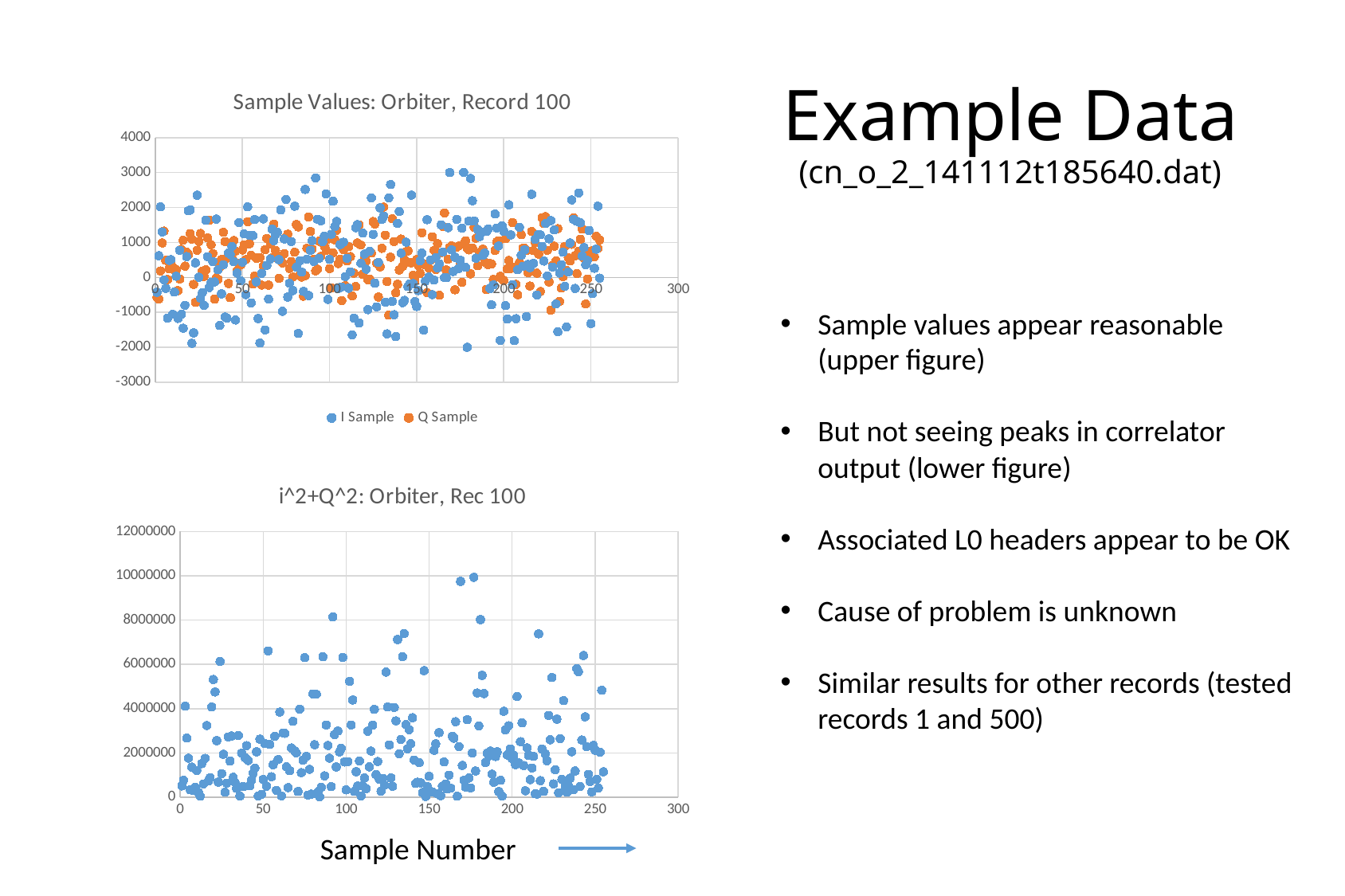
What kind of chart is the lower chart titled "i^2+Q^2: Orbiter, Rec 100"? scatter chart In the lower chart, is the highest plotted value greater or less than 8000000? greater How many series does the legend of the upper chart list? 2 In the upper chart, which series shows the wider spread of values, I Sample or Q Sample? I Sample What is the minimum value shown on the vertical axis of the upper chart? -3000 What are the two series named in the legend of the upper chart? I Sample and Q Sample What is the title of the lower chart? i^2+Q^2: Orbiter, Rec 100 In the upper chart, is the highest I Sample value greater or less than 2000? greater What kind of chart is the upper chart titled "Sample Values: Orbiter, Record 100"? scatter chart